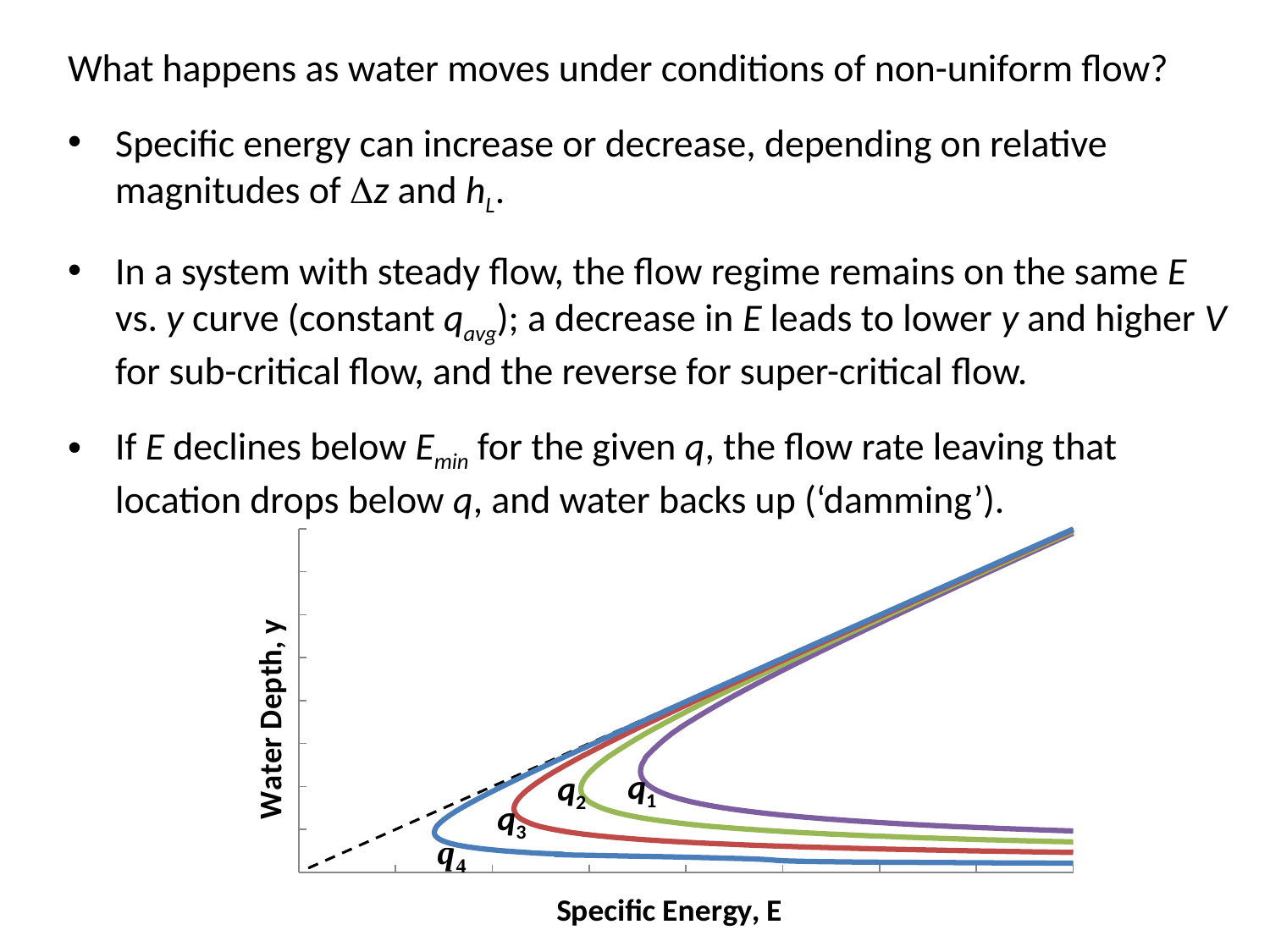
What is the label of the horizontal axis of the chart? Specific Energy, E What is the label of the vertical axis of the chart? Water Depth, y What kind of chart is shown on the slide? line chart Along the lower branches of the curves, does water depth rise or fall as specific energy increases? fall Which labelled curve has its leftmost point (minimum specific energy) closest to the vertical axis? q4 Which curve reaches its minimum specific energy at a smaller value of E, q2 or q4? q4 Which curve has the lowest lower branch at the right edge of the chart? q4 How many labelled q curves are plotted on the chart? 4 Which curve has the highest lower branch at the right edge of the chart? q1 Which curve reaches its minimum specific energy at a larger value of E, q1 or q3? q1 Along the upper branches of the curves, does water depth rise or fall as specific energy increases? rise Which labelled curve has its leftmost point (minimum specific energy) farthest from the vertical axis? q1